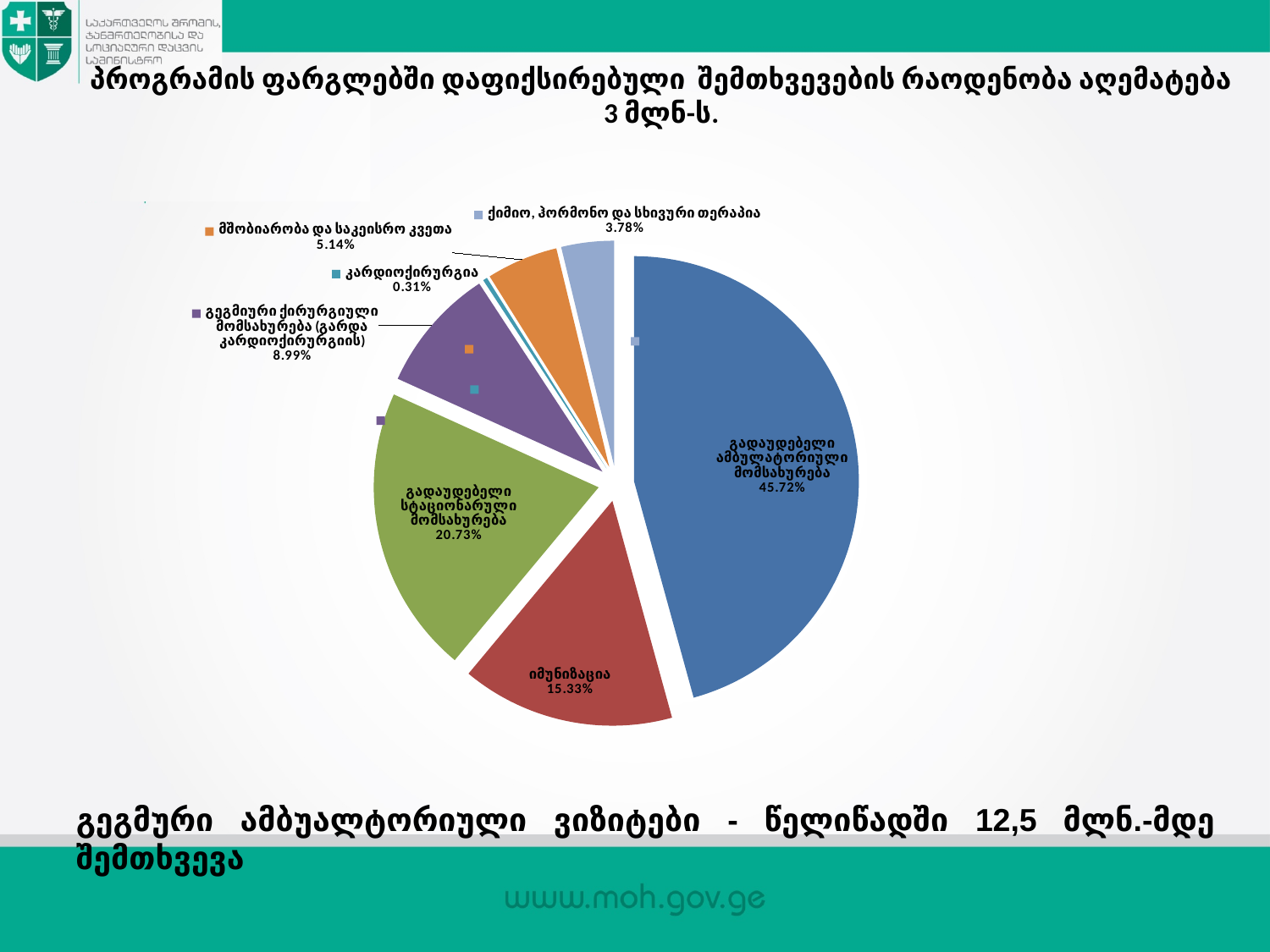
What is the value for ქიმიო, ჰორმონო და სხივური თერაპია? 3.78% What share of the pie does გადაუდებელი ამბულატორიული მომსახურება hold? 45.72% Which is larger: გეგმიური ქირურგიული მომსახურება (გარდა კარდიოქირურგიის) or მშობიარობა და საკეისრო კვეთა? გეგმიური ქირურგიული მომსახურება (გარდა კარდიოქირურგიის) What type of chart is shown on the slide? pie chart What is the value shown for იმუნიზაცია? 15.33% Which slice of the pie is the largest? გადაუდებელი ამბულატორიული მომსახურება Which slice of the pie is the smallest? კარდიოქირურგია What is the difference in percentage points between გადაუდებელი სტაციონარული მომსახურება and იმუნიზაცია? 5.40% How many slices does the pie chart have? 7 What percentage is labelled for მშობიარობა და საკეისრო კვეთა? 5.14% What is the value for კარდიოქირურგია? 0.31% What percentage is shown for გადაუდებელი სტაციონარული მომსახურება? 20.73%